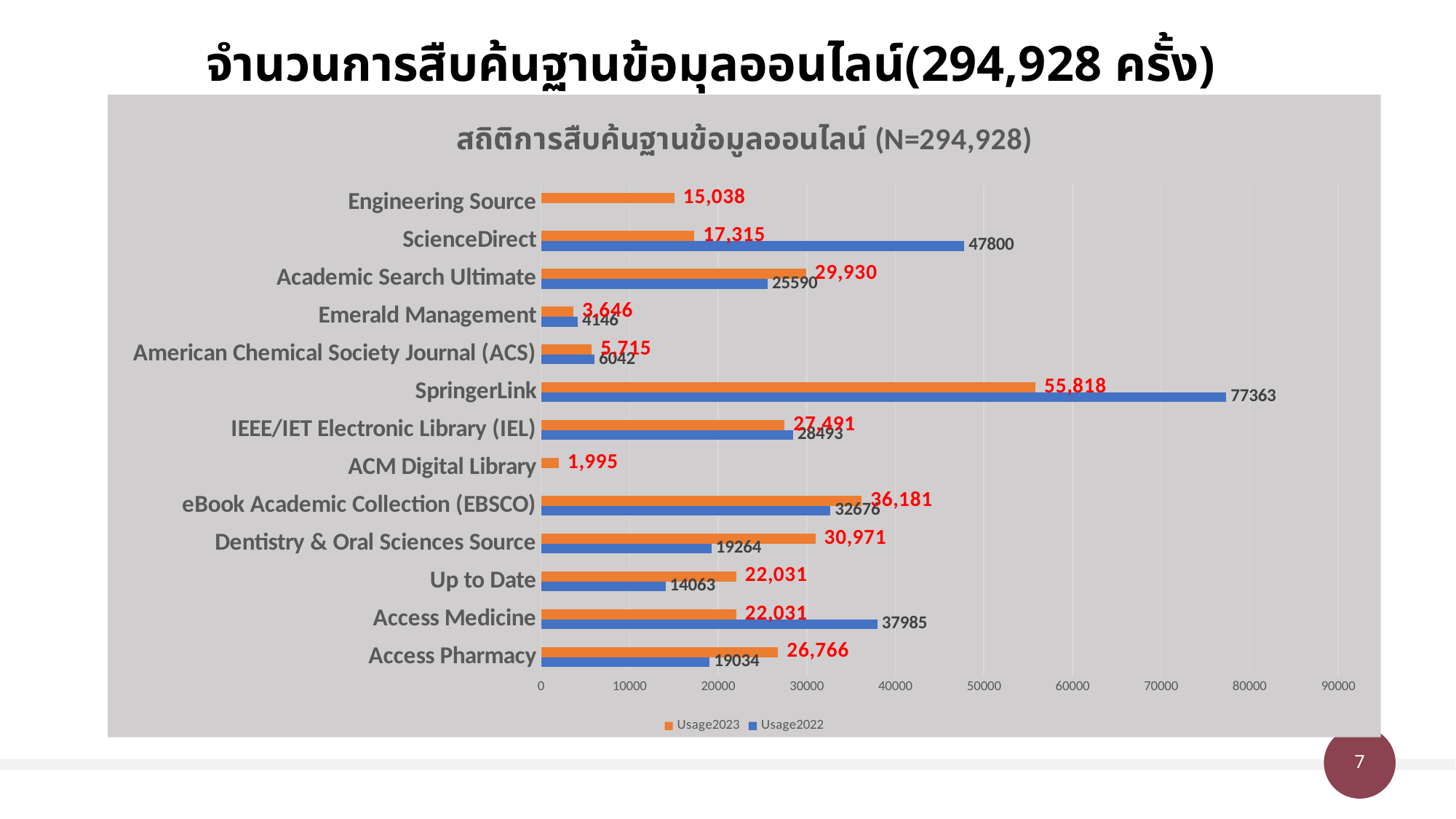
What kind of chart is shown on the slide? bar chart Which database has the highest Usage2023 value? SpringerLink How many databases are listed on the chart? 13 Is the Usage2022 value for SpringerLink greater or less than 70000? greater What is the difference between the Usage2022 and Usage2023 values for SpringerLink? 21,545 Which database has the highest Usage2022 value? SpringerLink What is the Usage2023 value for SpringerLink? 55,818 For Access Medicine, which is larger: Usage2023 or Usage2022? Usage2022 What is the Usage2022 value for Up to Date? 14063 What is the Usage2022 value for ScienceDirect? 47800 How many series does the legend list? 2 Which database has the lowest Usage2023 value? ACM Digital Library